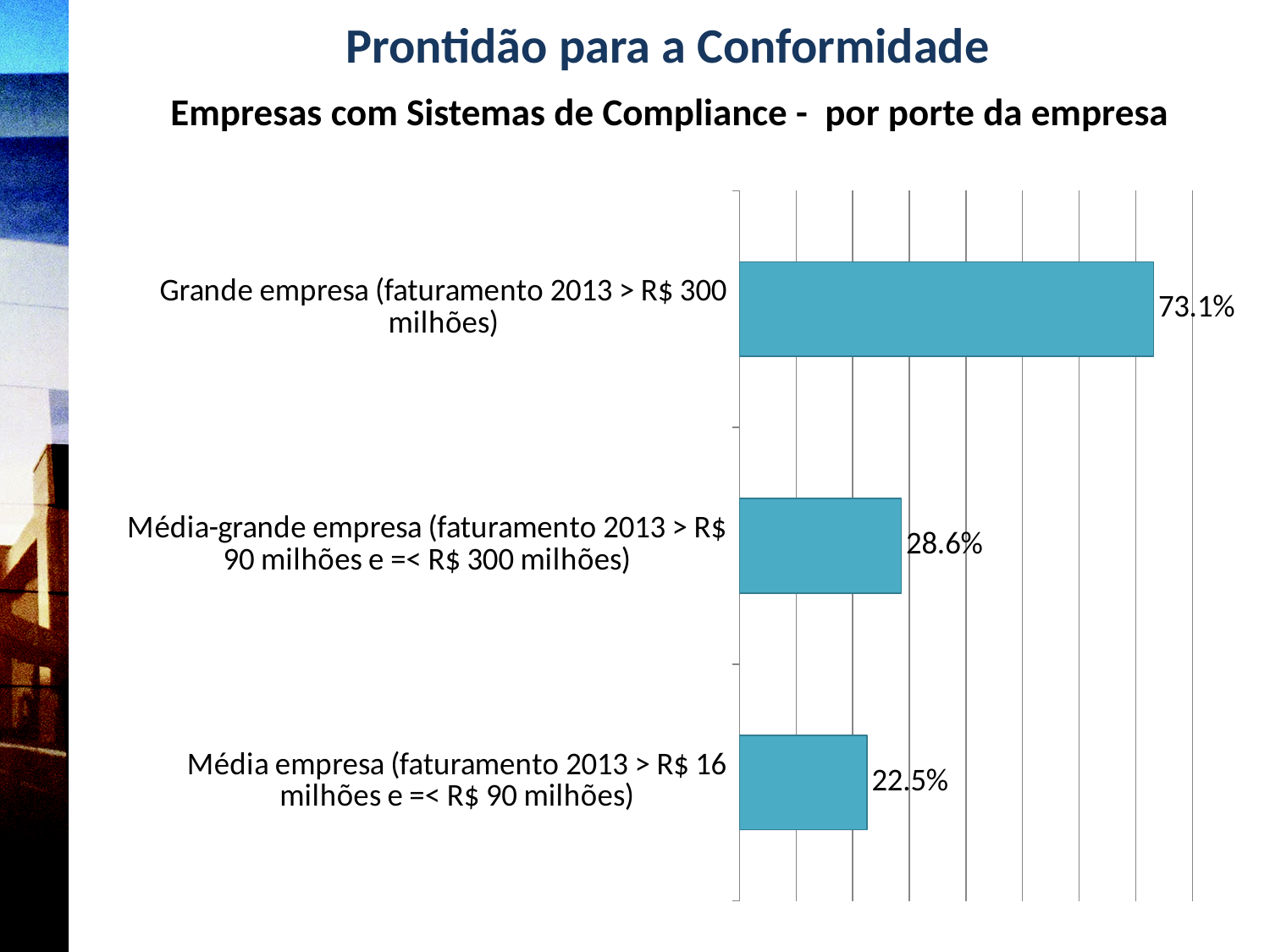
What percentage of large companies (Grande empresa) have compliance systems? 73.1% What type of chart is shown on the slide? Bar chart What is the difference in percentage points between Grande empresa and Média empresa? 50.6 Which has a larger value, Média-grande empresa or Média empresa? Média-grande empresa Which company size category has the lowest share of companies with compliance systems? Média empresa What colour are the bars in the chart? Teal blue How many company size categories are shown in the chart? 3 What is the subtitle describing the chart? Empresas com Sistemas de Compliance - por porte da empresa What is the value shown for Média empresa? 22.5% What is the difference in percentage points between Média-grande empresa and Média empresa? 6.1 What is the value shown for Média-grande empresa? 28.6% Which company size category has the highest share of companies with compliance systems? Grande empresa